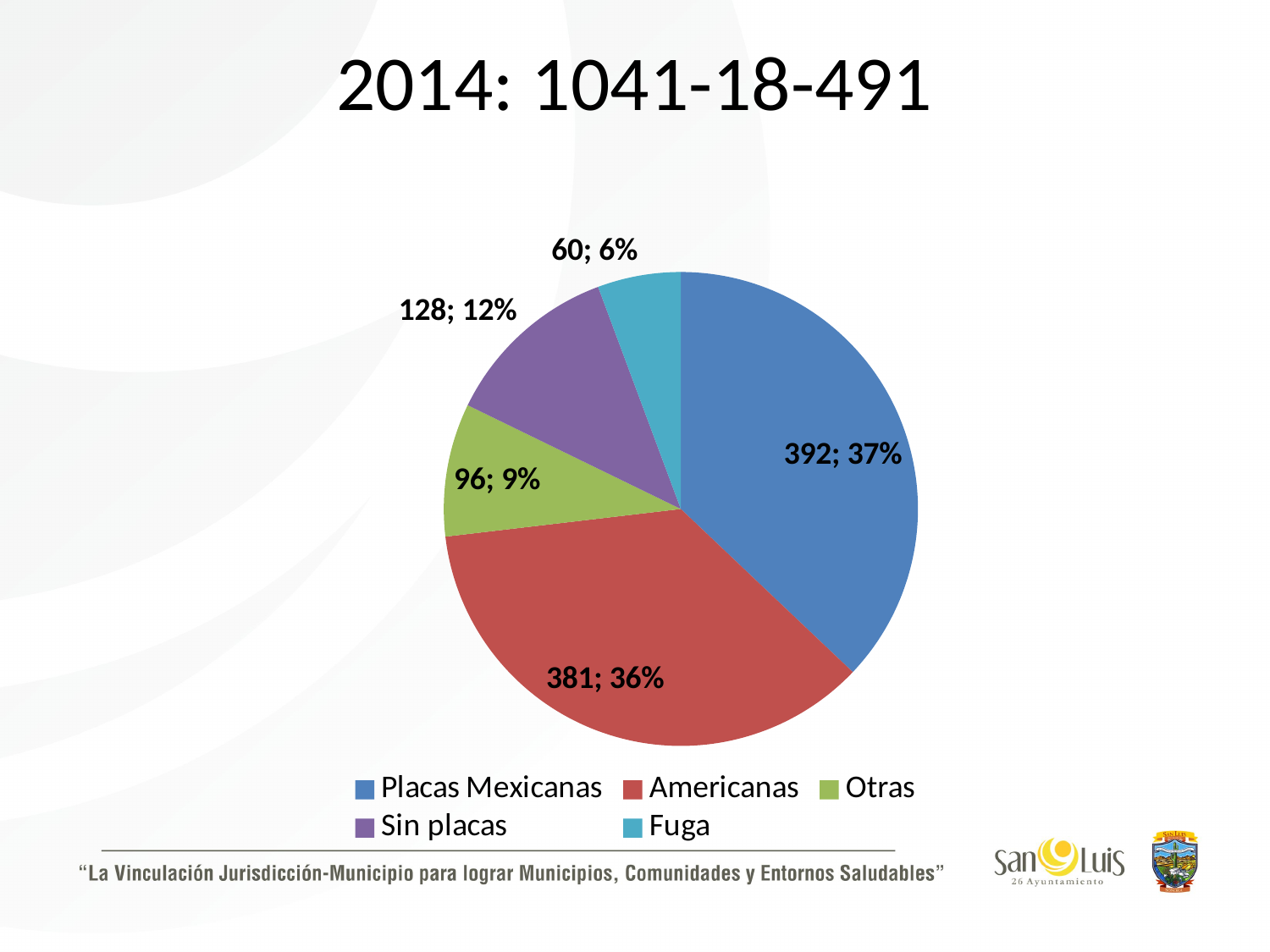
What is the value for Fuga? 60 What is the title of the slide? 2014: 1041-18-491 What is the difference between the values for Placas Mexicanas and Americanas? 11 How many categories does the legend list? 5 What share of the pie does Sin placas represent? 12% What is the value for Americanas? 381 Which category has the smallest slice of the pie? Fuga What is the value for Sin placas? 128 What share of the pie does Otras represent? 9% What kind of chart is shown on the slide? pie chart What is the value for Placas Mexicanas? 392 Which category has the largest slice of the pie? Placas Mexicanas